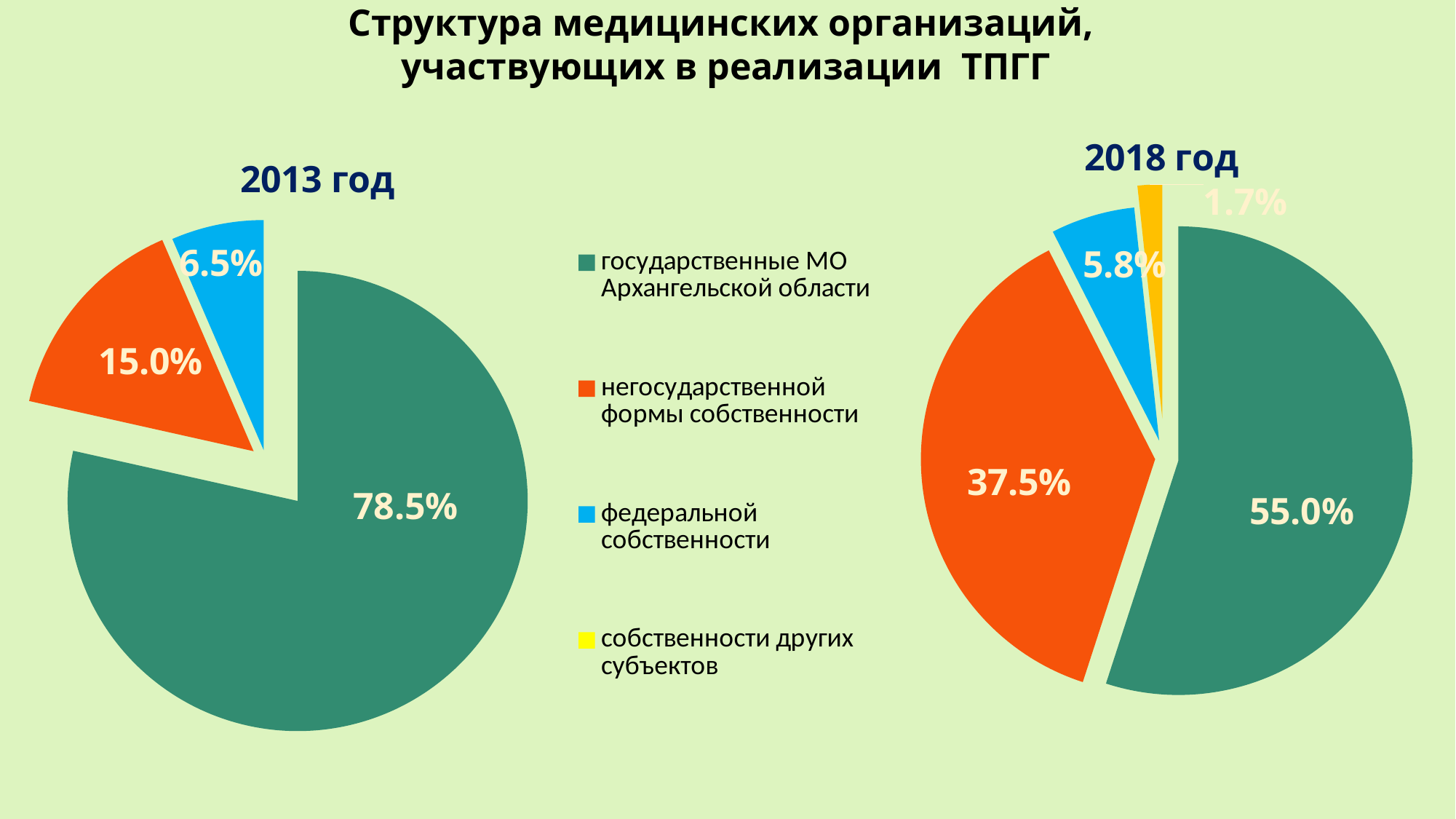
How many categories does the legend list? 4 In the 2018 год pie chart, which category has the smallest slice? собственности других субъектов In the 2018 год pie chart, which category has the largest slice? государственные МО Архангельской области In the 2013 год pie chart, which category has the smallest slice? федеральной собственности In the 2013 год pie chart, what share is shown for федеральной собственности? 6.5% In the 2018 год pie chart, what share do негосударственной формы собственности organisations have? 37.5% In the 2013 год pie chart, what share do государственные МО Архангельской области have? 78.5% What is the difference between the share of государственные МО Архангельской области in the 2013 год chart and in the 2018 год chart? 23.5% In the 2018 год pie chart, what share is shown for собственности других субъектов? 1.7% What type of chart is used on this slide? Pie chart Which is larger: the share of негосударственной формы собственности in the 2013 год chart or in the 2018 год chart? 2018 год How many slices does the 2018 год pie chart have? 4